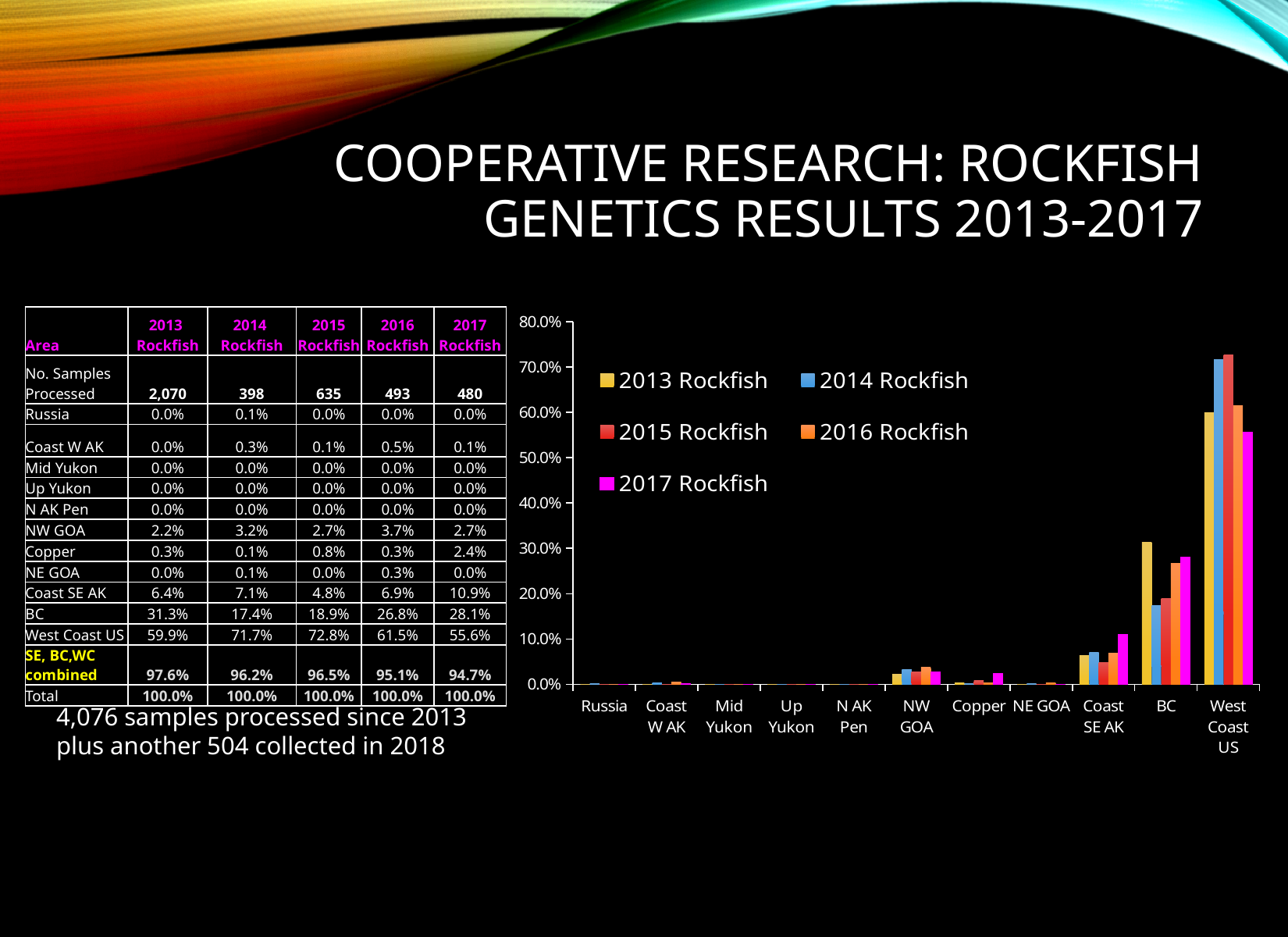
What is the 2017 Rockfish value for Coast SE AK, as printed in the table? 10.9% How many area categories are shown along the x axis of the chart? 11 Is the 2016 Rockfish value for BC greater or less than 20%? greater What colour represents the 2017 Rockfish series in the chart? magenta How many series does the chart's legend list? 5 Which area has the tallest bars in the chart? West Coast US Is the 2014 Rockfish value for West Coast US greater or less than 70%? greater What is the 2013 Rockfish value for BC, as printed in the table? 31.3% For West Coast US, which is larger: the 2015 Rockfish value or the 2017 Rockfish value? 2015 Rockfish What kind of chart is shown on the right of the slide? bar chart Among the West Coast US bars, which year has the lowest value? 2017 Rockfish Is the 2017 Rockfish value for BC greater or less than 30%? less